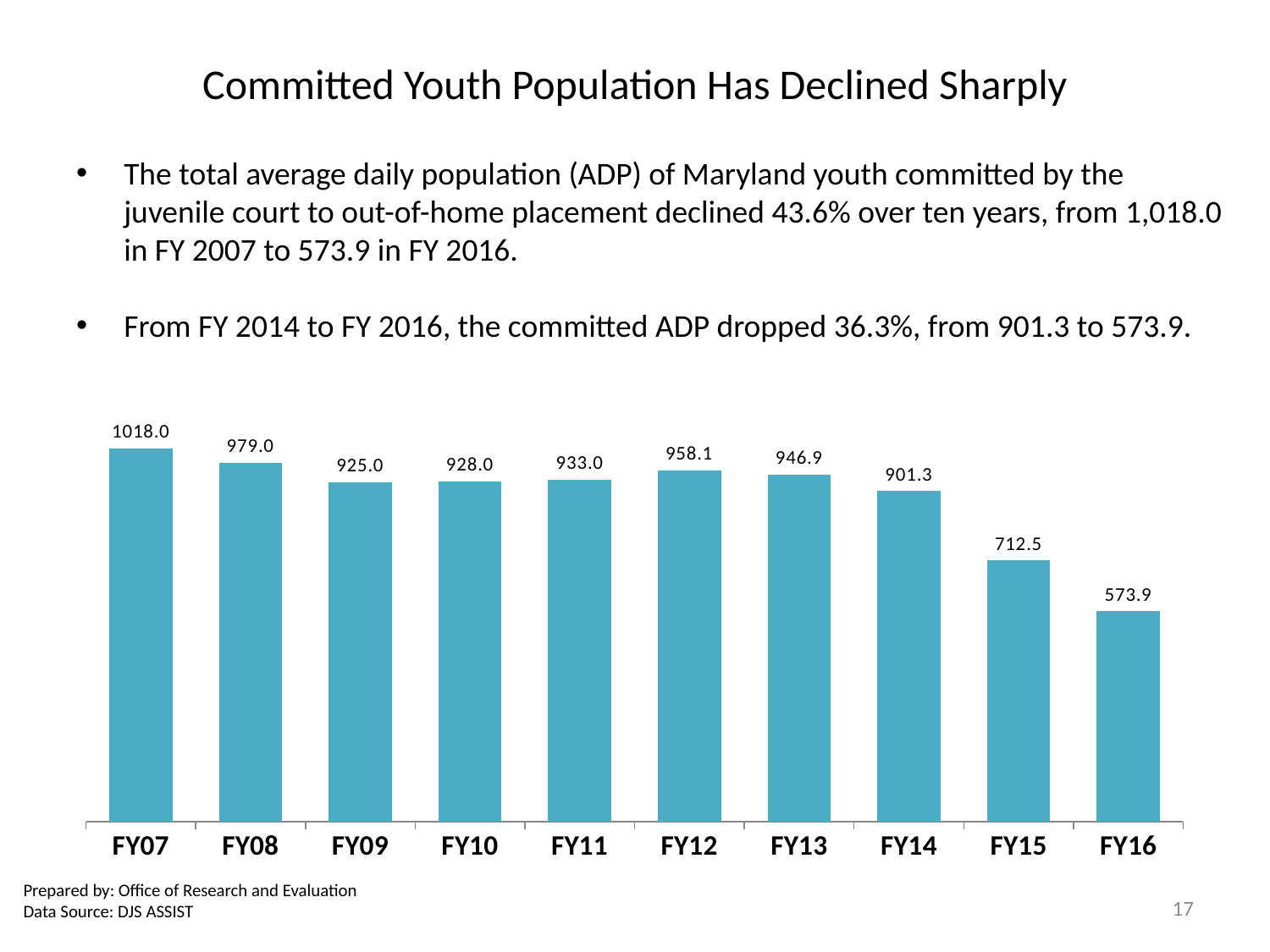
Which is larger, the value for FY12 or the value for FY13? FY12 How many fiscal years are shown on the chart? 10 What is the difference between the values for FY14 and FY16? 327.4 What is the value for FY15? 712.5 Which fiscal year has the highest value? FY07 Which fiscal year has the lowest value? FY16 What is the difference between the values for FY07 and FY08? 39.0 What kind of chart is shown on the slide? bar chart What is the title of the slide containing the chart? Committed Youth Population Has Declined Sharply Do the values generally rise or fall from FY07 to FY16? fall What is the value for FY07? 1018.0 What is the value for FY12? 958.1